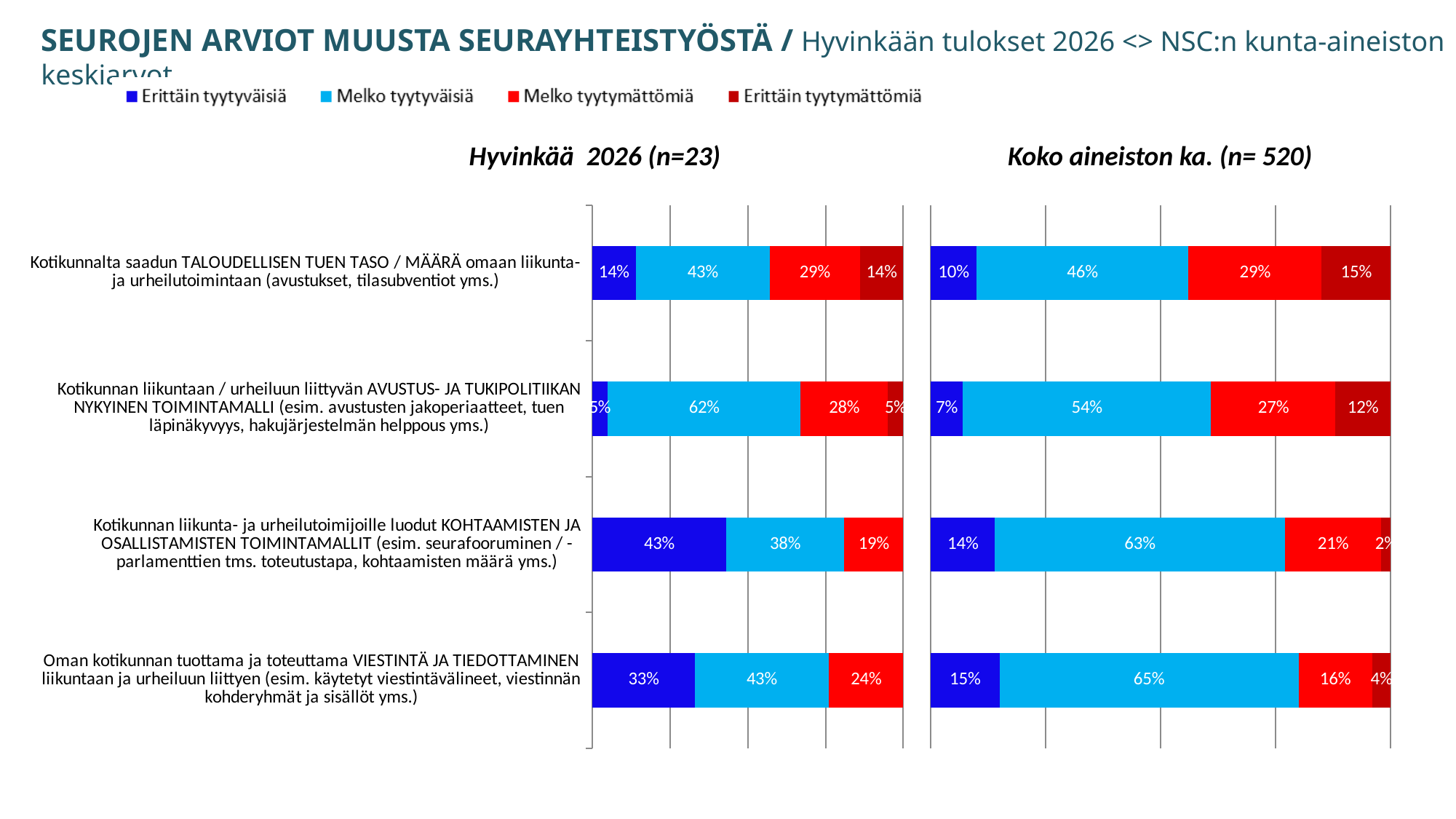
What kind of chart is the Hyvinkää 2026 (n=23) chart? Stacked bar chart How many series does the legend list? 4 In the Hyvinkää 2026 (n=23) chart, what percentage is 'Erittäin tyytyväisiä' for the category about KOHTAAMISTEN JA OSALLISTAMISTEN TOIMINTAMALLIT? 43% In the Hyvinkää 2026 (n=23) chart, what is the combined share of 'Melko tyytymättömiä' and 'Erittäin tyytymättömiä' for the category about TALOUDELLISEN TUEN TASO / MÄÄRÄ? 43% For the category about TALOUDELLISEN TUEN TASO / MÄÄRÄ, is the 'Erittäin tyytyväisiä' share larger in the Hyvinkää 2026 chart or in the Koko aineiston ka. chart? Hyvinkää 2026 In the Koko aineiston ka. (n= 520) chart, which category has the lowest 'Melko tyytyväisiä' share? Kotikunnalta saadun TALOUDELLISEN TUEN TASO / MÄÄRÄ omaan liikunta- ja urheilutoimintaan In the Hyvinkää 2026 (n=23) chart, what percentage is 'Melko tyytyväisiä' for the category about KOTIKUNNAN LIIKUNTAAN / URHEILUUN LIITTYVÄN AVUSTUS- JA TUKIPOLITIIKAN NYKYINEN TOIMINTAMALLI? 62% In the Koko aineiston ka. (n= 520) chart, what percentage is 'Melko tyytyväisiä' for the category about VIESTINTÄ JA TIEDOTTAMINEN? 65% In the Koko aineiston ka. (n= 520) chart, what percentage is 'Erittäin tyytymättömiä' for the category about KOTIKUNNALTA SAADUN TALOUDELLISEN TUEN TASO / MÄÄRÄ? 15% What is the difference between the 'Melko tyytyväisiä' share for VIESTINTÄ JA TIEDOTTAMINEN in the Koko aineiston ka. chart and in the Hyvinkää 2026 chart? 22 percentage points How many categories are shown in the Koko aineiston ka. (n= 520) chart? 4 In the Hyvinkää 2026 (n=23) chart, which category has the highest 'Erittäin tyytyväisiä' share? Kotikunnan liikunta- ja urheilutoimijoille luodut KOHTAAMISTEN JA OSALLISTAMISTEN TOIMINTAMALLIT